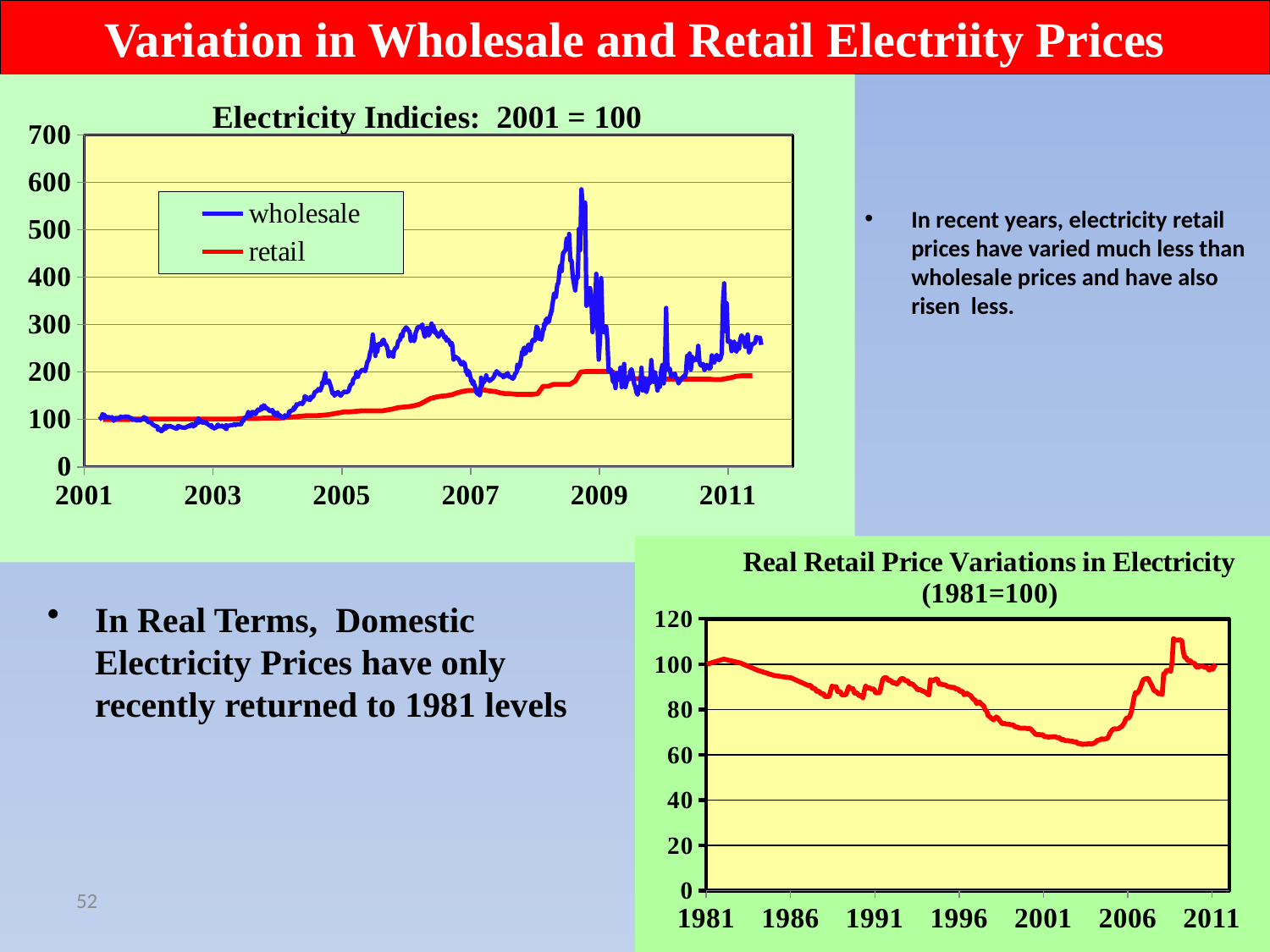
What kind of chart is the 'Real Retail Price Variations in Electricity (1981=100)' chart? line chart In the 'Real Retail Price Variations in Electricity (1981=100)' chart, is the highest value reached around 2008-2009 greater or less than 100? greater In the 'Real Retail Price Variations in Electricity (1981=100)' chart, is the value around 2003 greater or less than 80? less How many series does the legend of the 'Electricity Indicies: 2001 = 100' chart list? 2 In the 'Electricity Indicies: 2001 = 100' chart, which series reaches the higher peak, wholesale or retail? wholesale What are the two series named in the legend of the 'Electricity Indicies: 2001 = 100' chart? wholesale and retail In the 'Electricity Indicies: 2001 = 100' chart, is the highest value of the wholesale series greater or less than 500? greater What kind of chart is the 'Electricity Indicies: 2001 = 100' chart? line chart What is the title of the chart in the bottom-right of the slide? Real Retail Price Variations in Electricity (1981=100) In the 'Real Retail Price Variations in Electricity (1981=100)' chart, do values rise or fall between 1981 and 2003? fall